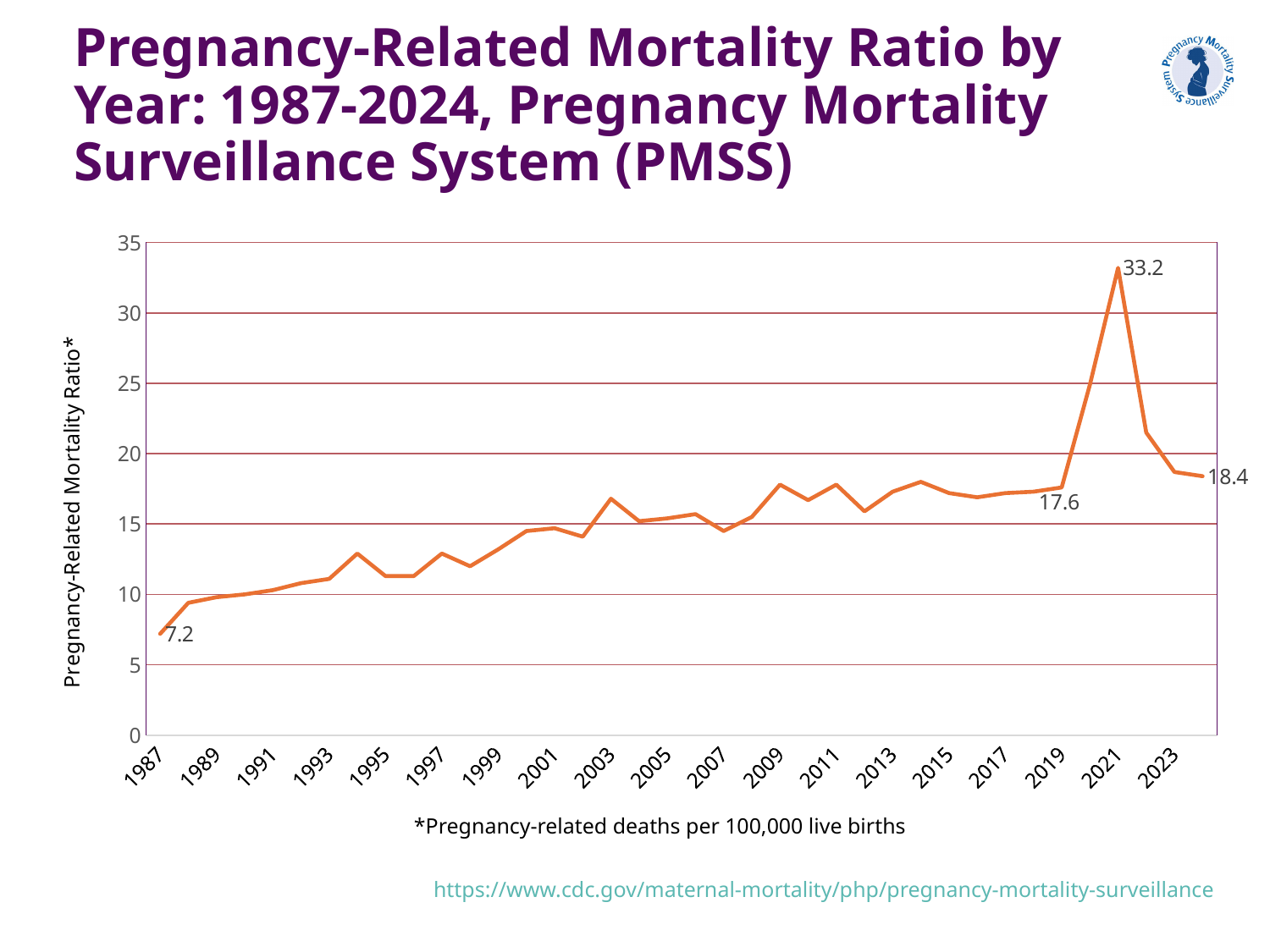
Does the pregnancy-related mortality ratio rise or fall from 2021 to 2024? fall What is the difference between the 2021 value and the 2019 value? 15.6 What is the pregnancy-related mortality ratio for 1987? 7.2 Is the value for 1995 greater or less than 15? less In which year is the pregnancy-related mortality ratio highest? 2021 What is the difference between the 2021 value and the 1987 value? 26.0 Is the value for 2009 greater or less than 15? greater What type of chart is shown on the slide? line chart What is the pregnancy-related mortality ratio for 2021? 33.2 What is the pregnancy-related mortality ratio for 2019? 17.6 What value is labelled at the final point of the line, for 2024? 18.4 In which year is the pregnancy-related mortality ratio lowest? 1987